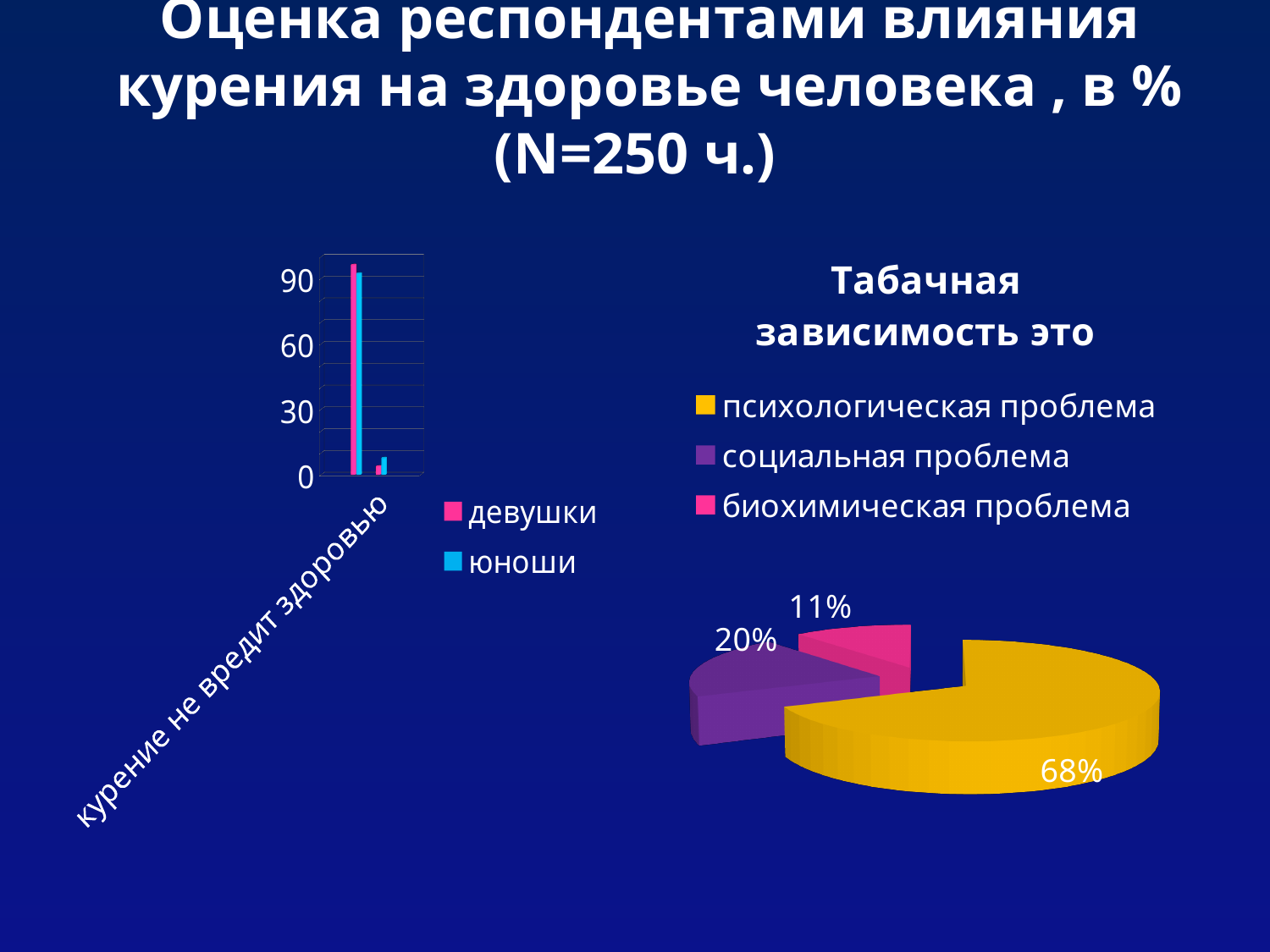
In the pie chart titled 'Табачная зависимость это', what share is labelled for 'психологическая проблема'? 68% In the pie chart titled 'Табачная зависимость это', what share is labelled for 'биохимическая проблема'? 11% In the pie chart titled 'Табачная зависимость это', which is larger: 'социальная проблема' or 'биохимическая проблема'? социальная проблема In the bar chart on the left, which colour represents the series 'юноши'? cyan (light blue) What kind of chart is the chart on the right of the slide? pie chart In the pie chart titled 'Табачная зависимость это', what share is labelled for 'социальная проблема'? 20% In the pie chart titled 'Табачная зависимость это', which slice is the smallest? биохимическая проблема In the pie chart titled 'Табачная зависимость это', what is the difference between the shares for 'психологическая проблема' and 'социальная проблема'? 48% How many slices does the pie chart titled 'Табачная зависимость это' have? 3 In the pie chart titled 'Табачная зависимость это', which slice is the largest? психологическая проблема What kind of chart is the chart on the left of the slide? bar chart How many series does the legend of the bar chart on the left list? 2